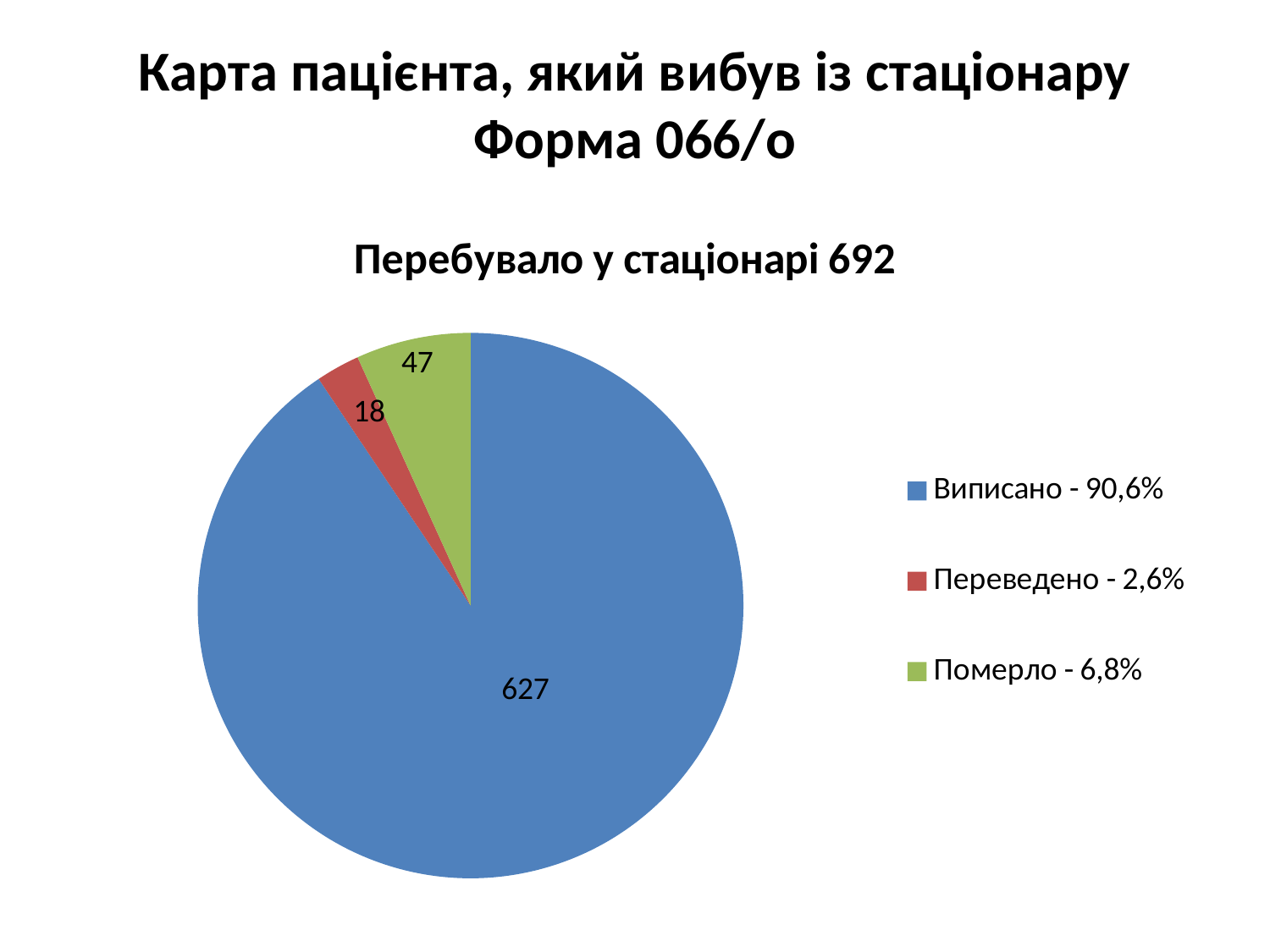
Which category has the largest slice of the pie? Виписано What is the title of the chart? Перебувало у стаціонарі 692 What is the value shown for the Померло slice? 47 What is the difference between the Померло value and the Переведено value? 29 Which category has the smallest slice of the pie? Переведено What is the value shown for the Виписано slice? 627 Which is larger, the Померло slice or the Переведено slice? Померло What colour is the Померло slice? green What kind of chart is shown on the slide? pie chart What share of the pie does the Виписано slice represent, according to the legend? 90,6% How many slices does the pie chart have? 3 What is the value shown for the Переведено slice? 18